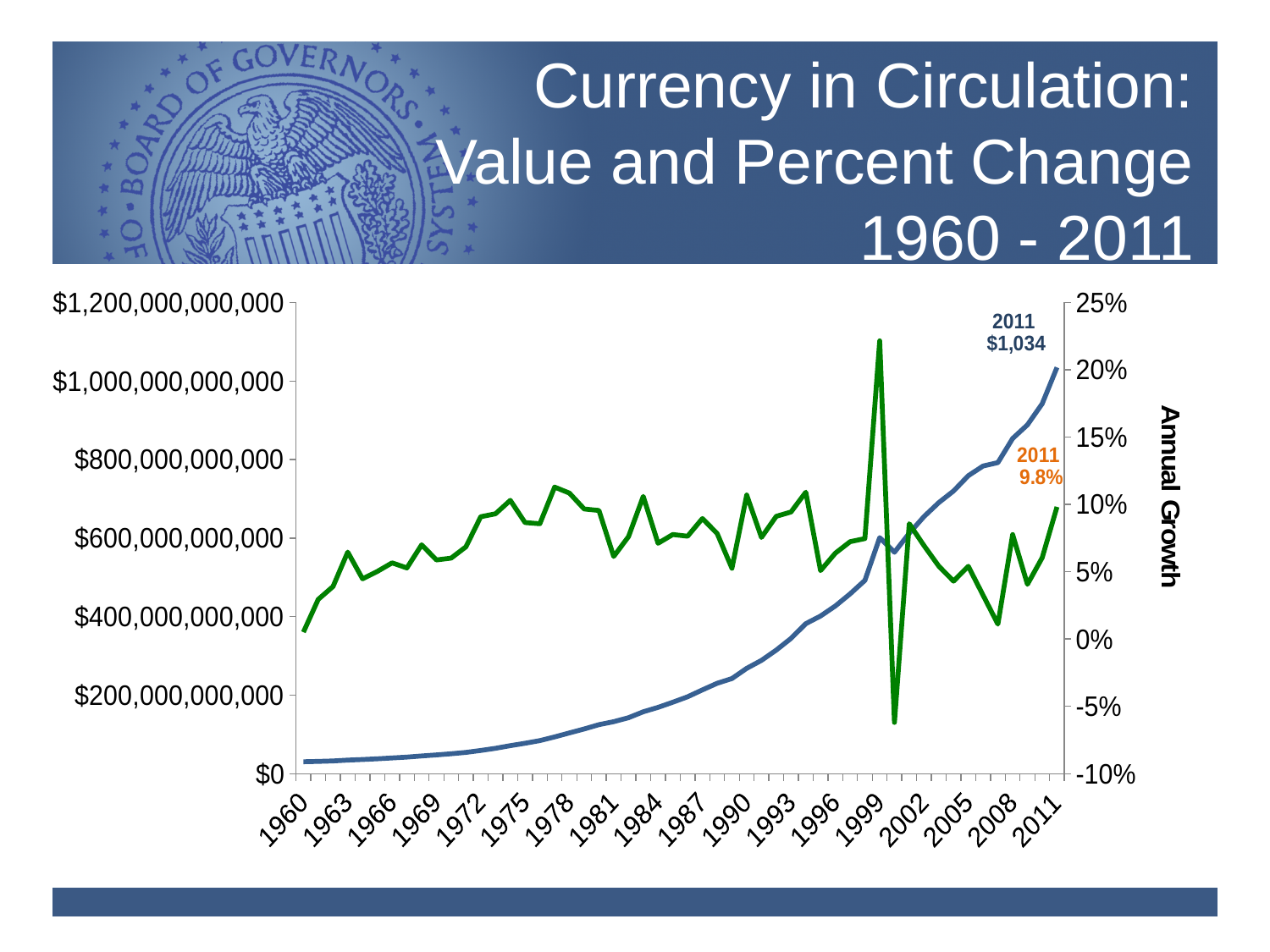
In which year does the green annual growth line reach its highest point? 1999 Does the blue currency in circulation line generally rise or fall from 1960 to 2011? rise In which year does the green annual growth line reach its lowest point? 2000 What annual growth rate is labelled for 2011 on the green line? 9.8% What kind of chart is shown on the slide? line chart How many lines are plotted on the chart? 2 What is the highest tick value shown on the left vertical axis? $1,200,000,000,000 Is the currency in circulation value for 1990 greater or less than $400,000,000,000? less Is the annual growth value for 1999 greater or less than 15%? greater Is the annual growth value for 2000 greater or less than 0%? less What value is labelled for 2011 on the blue currency-in-circulation line? $1,034 What is the title of the right-hand vertical axis? Annual Growth